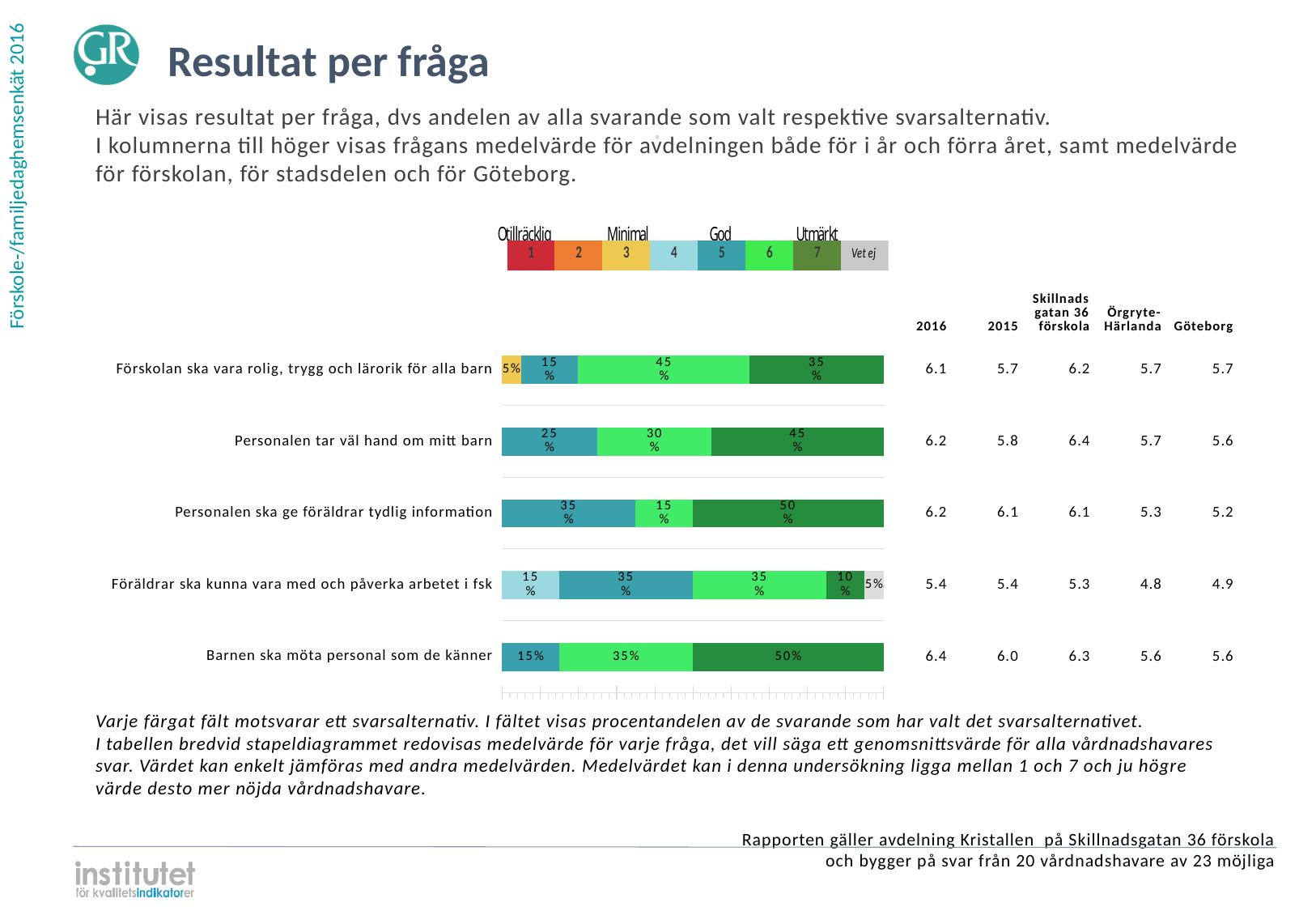
What percentage of respondents chose alternative 7 (dark green) for 'Personalen tar väl hand om mitt barn'? 45% What percentage chose alternative 5 (teal) for 'Personalen ska ge föräldrar tydlig information'? 35% For 'Barnen ska möta personal som de känner', which is larger: the share choosing alternative 6 or the share choosing alternative 7? Alternative 7 (50%) How many questions (categories) are shown in the bar chart? 5 Which question has the lowest 2016 mean value in the table? Föräldrar ska kunna vara med och påverka arbetet i fsk For 'Förskolan ska vara rolig, trygg och lärorik för alla barn', what is the difference between the share choosing alternative 6 and the share choosing alternative 7? 10 percentage points What percentage of respondents chose alternative 6 (light green) for 'Förskolan ska vara rolig, trygg och lärorik för alla barn'? 45% What is the 2016 mean value for 'Barnen ska möta personal som de känner'? 6.4 What kind of chart is used to show the results per question? Stacked bar chart What is the Göteborg mean value for 'Föräldrar ska kunna vara med och påverka arbetet i fsk'? 4.9 How many answer alternatives does the legend above the chart list? 8 What percentage chose 'Vet ej' for 'Föräldrar ska kunna vara med och påverka arbetet i fsk'? 5%